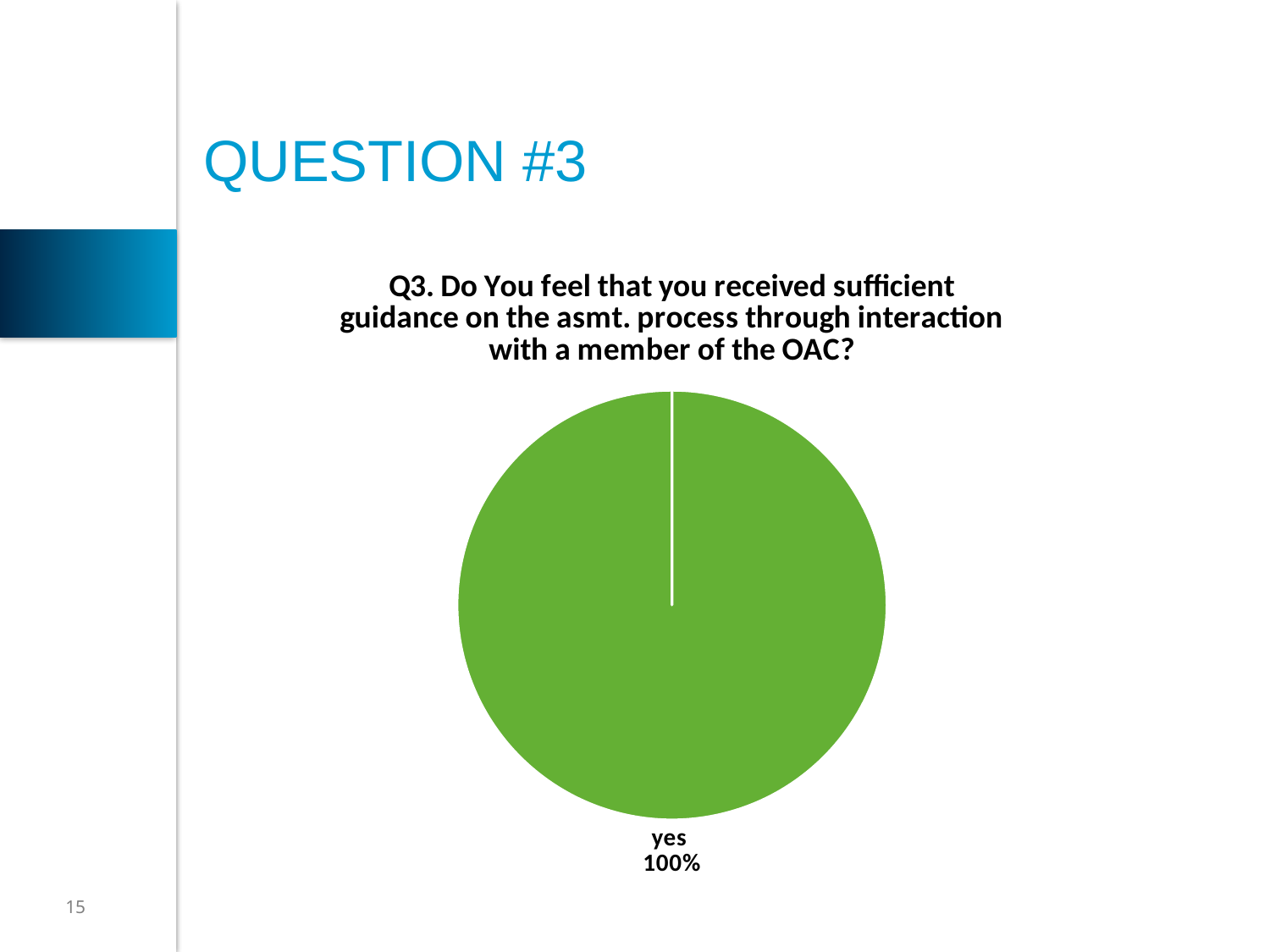
How many slices does the pie chart have? 1 What share of the pie does the "yes" slice represent? 100% Which category is the largest slice of the pie? yes Is the value for "yes" greater or less than 50%? greater What is the title of the chart? Q3. Do You feel that you received sufficient guidance on the asmt. process through interaction with a member of the OAC? What is the value shown for the "yes" category? 100% What colour is the "yes" slice of the pie? green What kind of chart is shown on the slide? pie chart